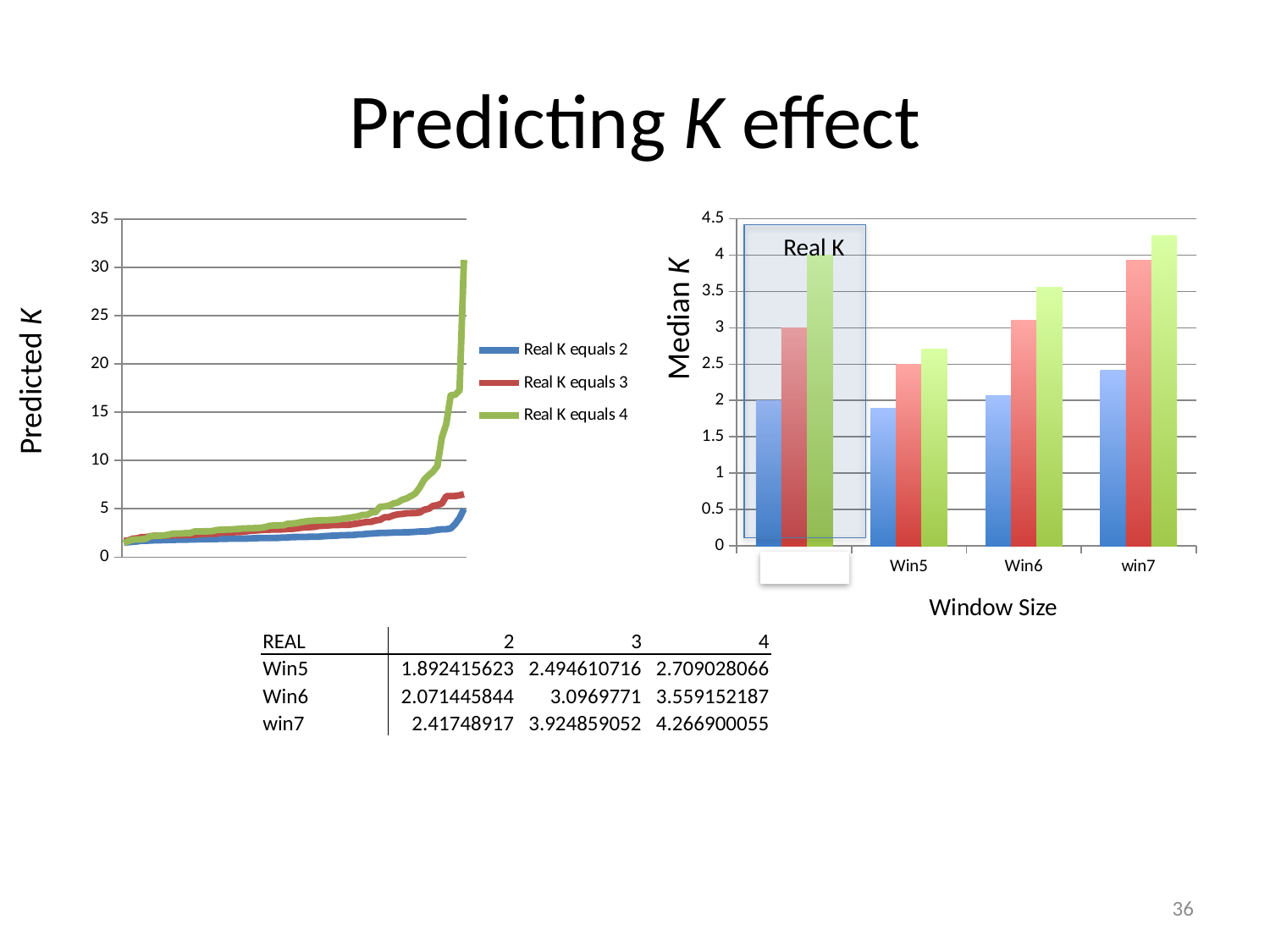
In the right chart (Median K), which window size has the highest red bar? win7 In the right chart (Median K), is the blue bar for Win5 greater or less than 2? less In the left chart (Predicted K), do the values rise or fall along the x axis? rise In the right chart (Median K), which is larger: the red bar for Win6 or the green bar for Win5? the red bar for Win6 What is the x axis title of the right chart (Median K)? Window Size What kind of chart is the left chart with the y axis labelled Predicted K? line chart In the left chart (Predicted K), which series reaches the highest value? Real K equals 4 In the right chart (Median K), which window size has the lowest blue bar? Win5 In the left chart (Predicted K), how many series does the legend list? 3 What kind of chart is the right chart with the y axis labelled Median K? bar chart In the right chart (Median K), how many window sizes are labelled on the x axis? 3 In the right chart (Median K), is the green bar for win7 greater or less than 4? greater